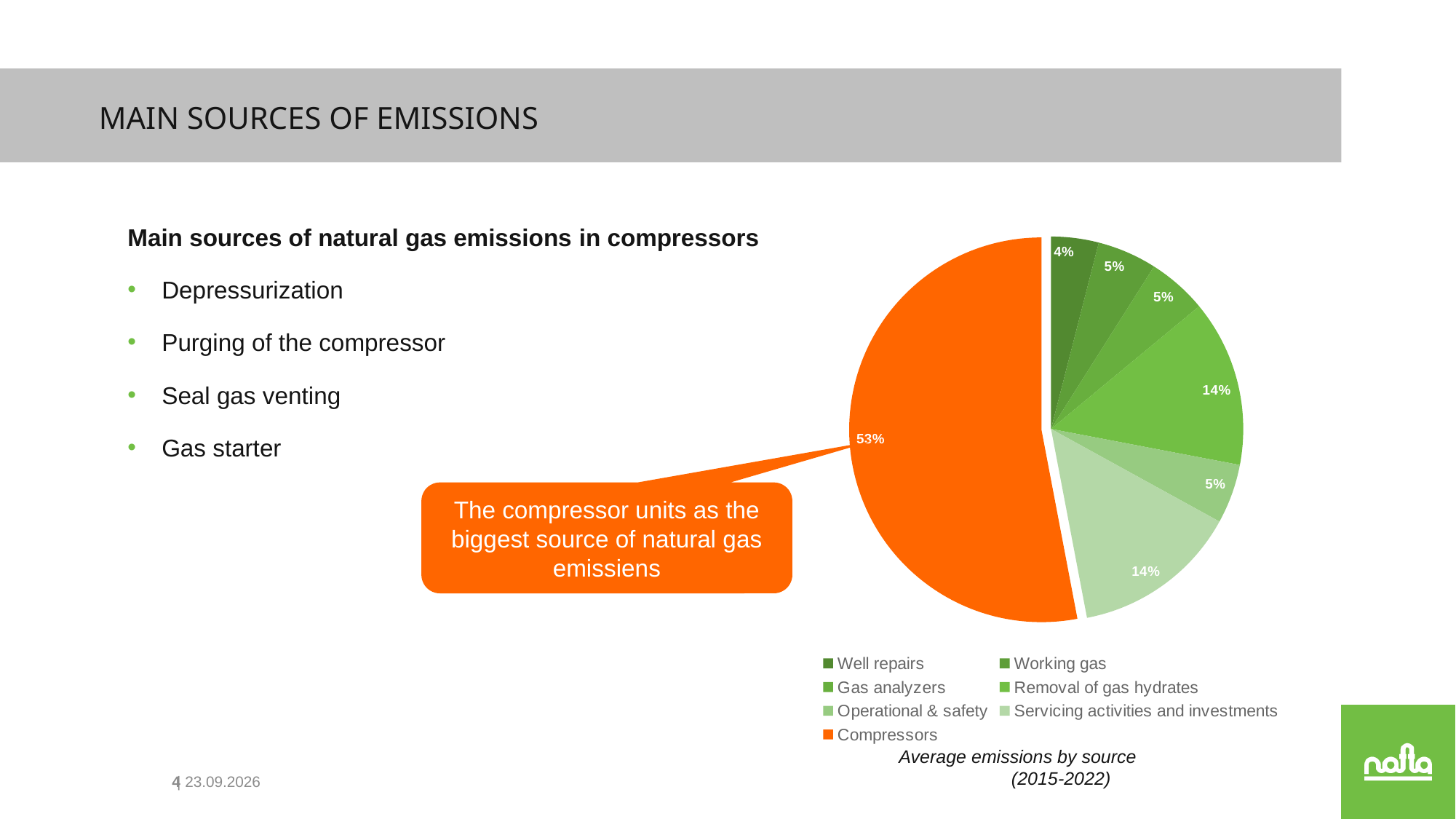
Which is larger, the share for Removal of gas hydrates or the share for Operational & safety? Removal of gas hydrates What is the difference in percentage points between Compressors and Servicing activities and investments? 39% What share of the pie does Compressors account for? 53% What kind of chart is shown on the slide? Pie chart What percentage is shown for Servicing activities and investments? 14% Which source has the smallest share of emissions in the pie chart? Well repairs What percentage is shown for Removal of gas hydrates? 14% Which legend entry is shown in orange? Compressors Which source has the largest share of emissions in the pie chart? Compressors How many sources (slices) are shown in the pie chart? 7 What percentage is shown for Well repairs? 4% What is the title of the chart? Average emissions by source (2015-2022)